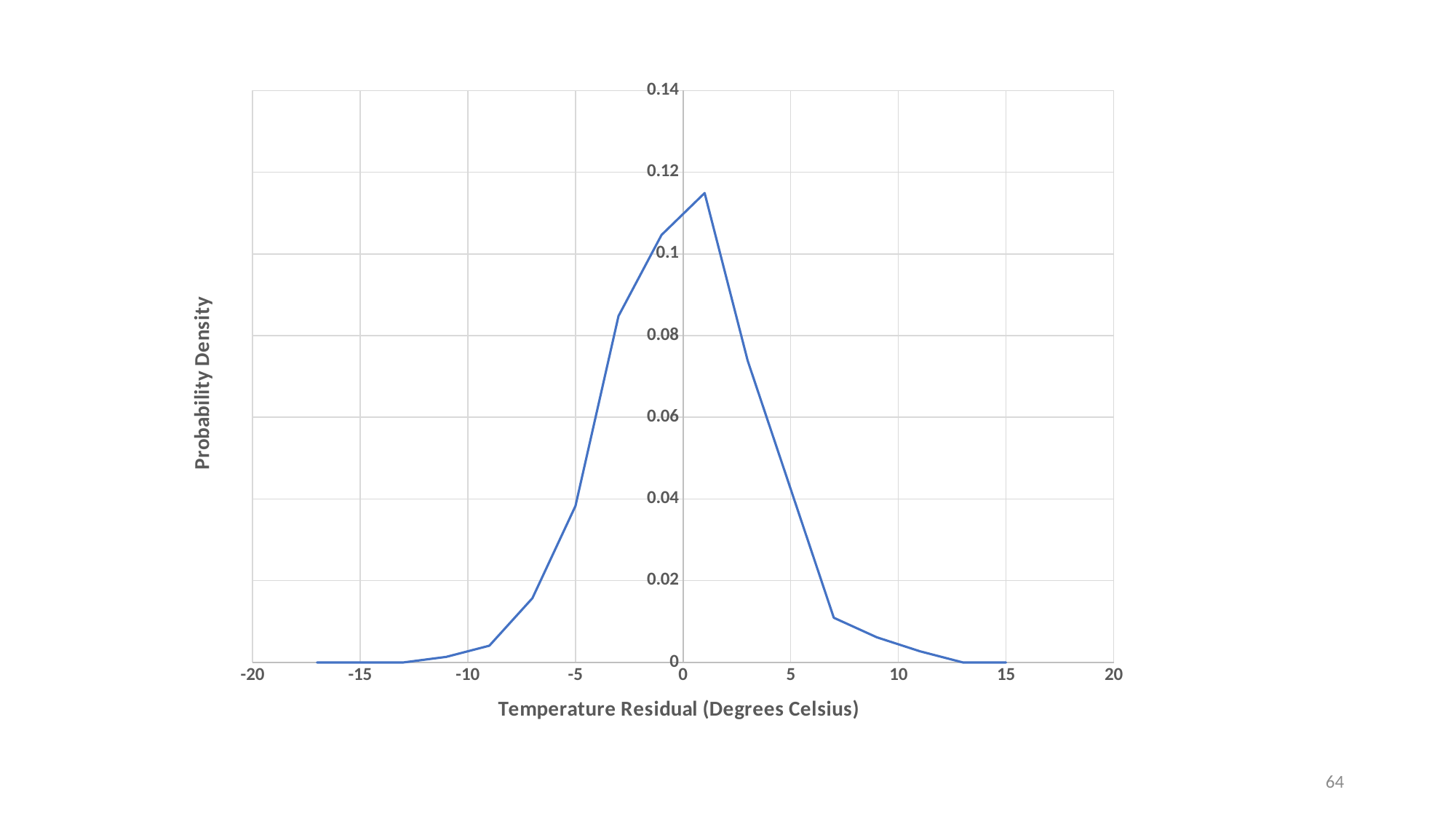
Do the values rise or fall as the temperature residual increases from 5 to 15? fall Is the probability density at a temperature residual of 7 greater or less than 0.02? less What is the title of the y axis? Probability Density Is the peak value of the curve greater or less than 0.1? greater Do the values rise or fall as the temperature residual increases from -15 to 0? rise Is the probability density at a temperature residual of -3 greater or less than 0.08? greater Which is larger, the probability density at a temperature residual of -5 or at 5? 5 What kind of chart is shown on the slide? line chart What is the title of the x axis? Temperature Residual (Degrees Celsius)